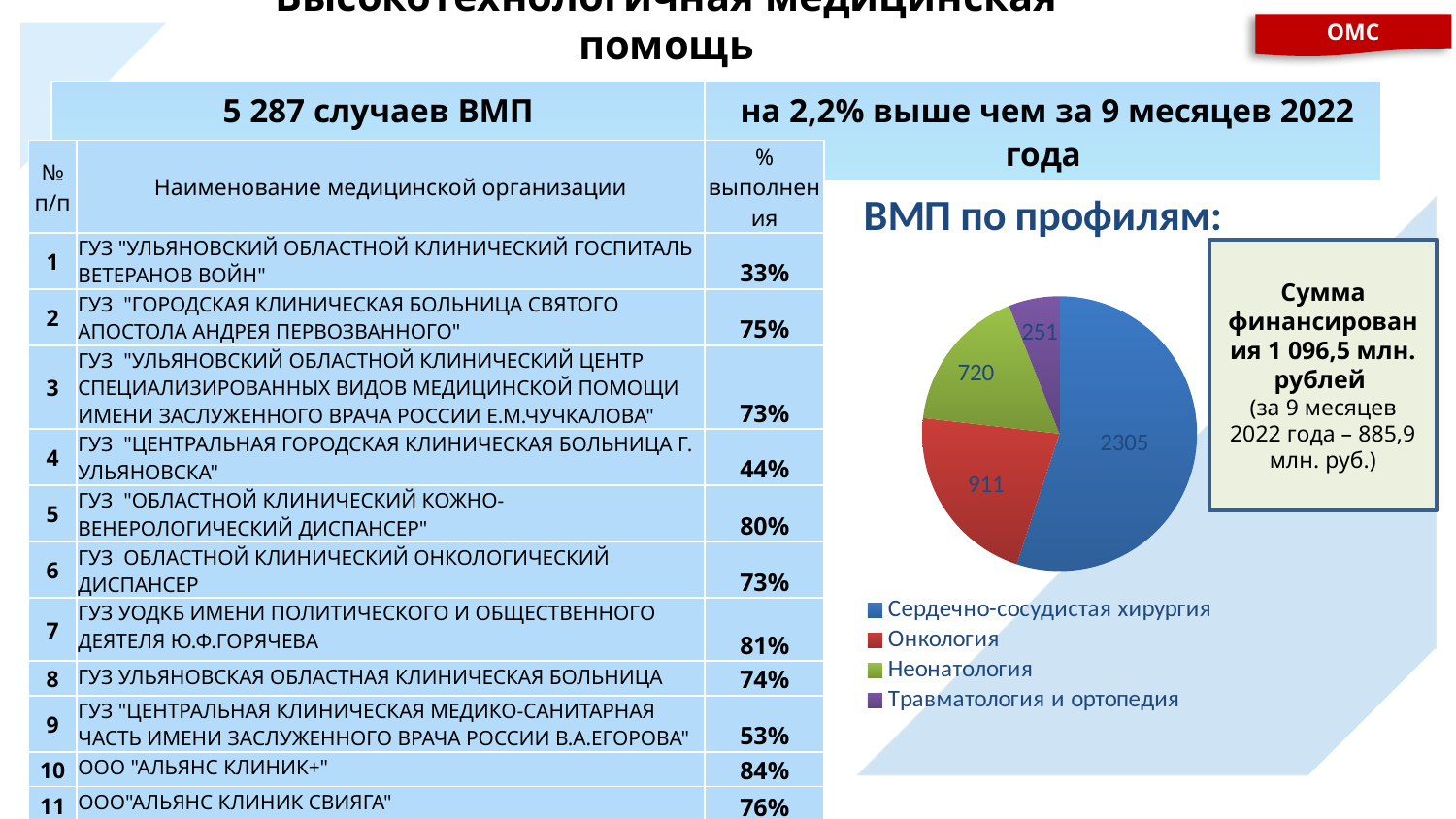
In the pie chart "ВМП по профилям", what is the value for Неонатология? 720 In the pie chart "ВМП по профилям", what colour is the slice for Неонатология? green In the pie chart "ВМП по профилям", what is the difference between the values for Неонатология and Травматология и ортопедия? 469 In the pie chart "ВМП по профилям", what is the difference between the values for Сердечно-сосудистая хирургия and Онкология? 1394 In the pie chart "ВМП по профилям", what is the value for Сердечно-сосудистая хирургия? 2305 What kind of chart is shown under the heading "ВМП по профилям"? pie chart How many slices does the pie chart "ВМП по профилям" have? 4 In the pie chart "ВМП по профилям", which profile has the largest value? Сердечно-сосудистая хирургия In the pie chart "ВМП по профилям", which is larger: the value for Онкология or the value for Неонатология? Онкология In the pie chart "ВМП по профилям", what is the value for Травматология и ортопедия? 251 In the pie chart "ВМП по профилям", which profile has the smallest value? Травматология и ортопедия In the pie chart "ВМП по профилям", what is the value for Онкология? 911